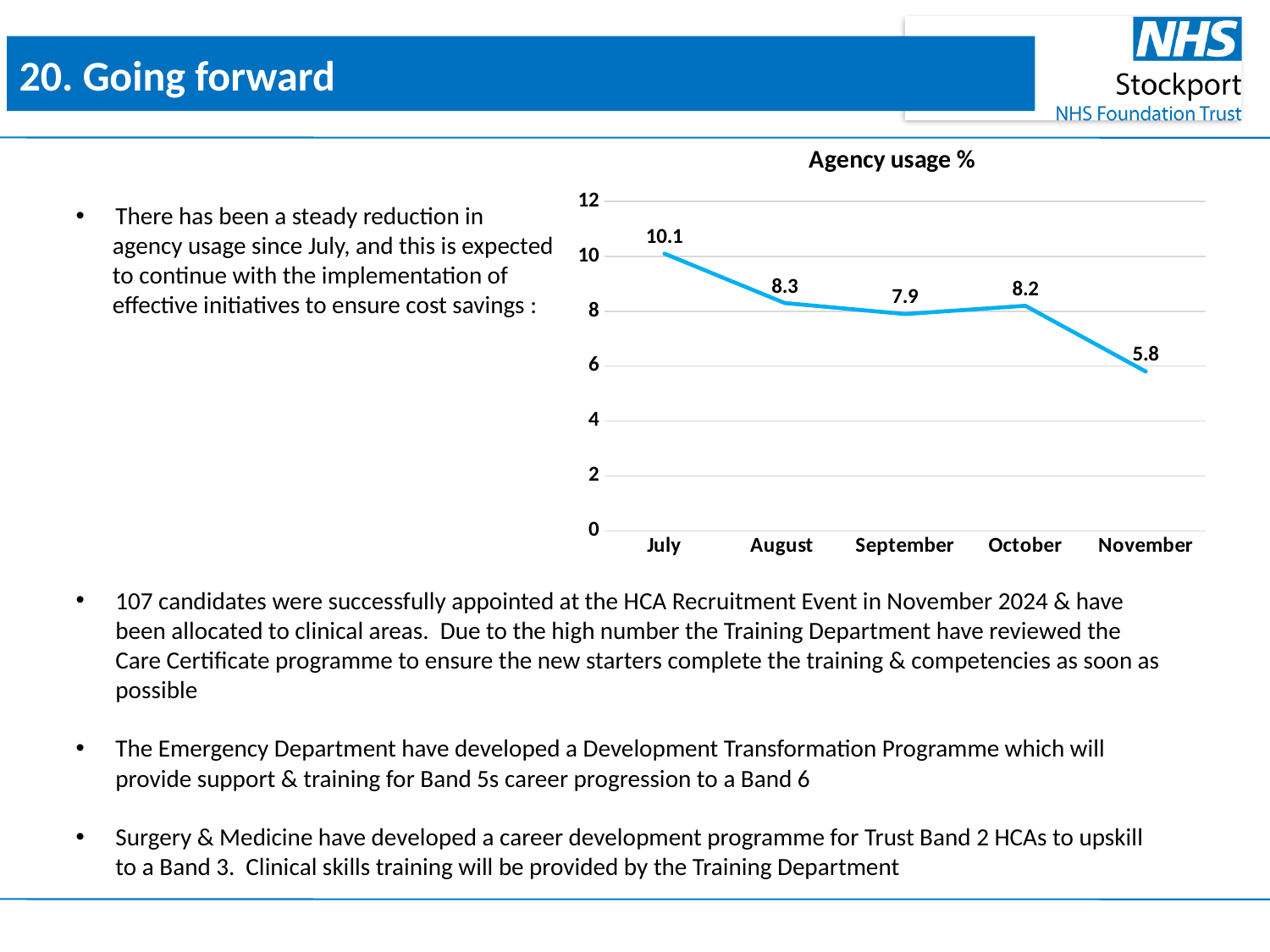
Is the agency usage % for October greater or less than 6? greater What is the title of the chart? Agency usage % Which month has the lowest agency usage %? November How many months are plotted on the chart? 5 What is the agency usage % for July? 10.1 Which month has the highest agency usage %? July What kind of chart is shown on the slide? Line chart What is the difference in agency usage % between July and November? 4.3 Which month has a higher agency usage %, August or October? August What is the agency usage % for September? 7.9 What is the agency usage % for November? 5.8 What is the difference in agency usage % between August and September? 0.4